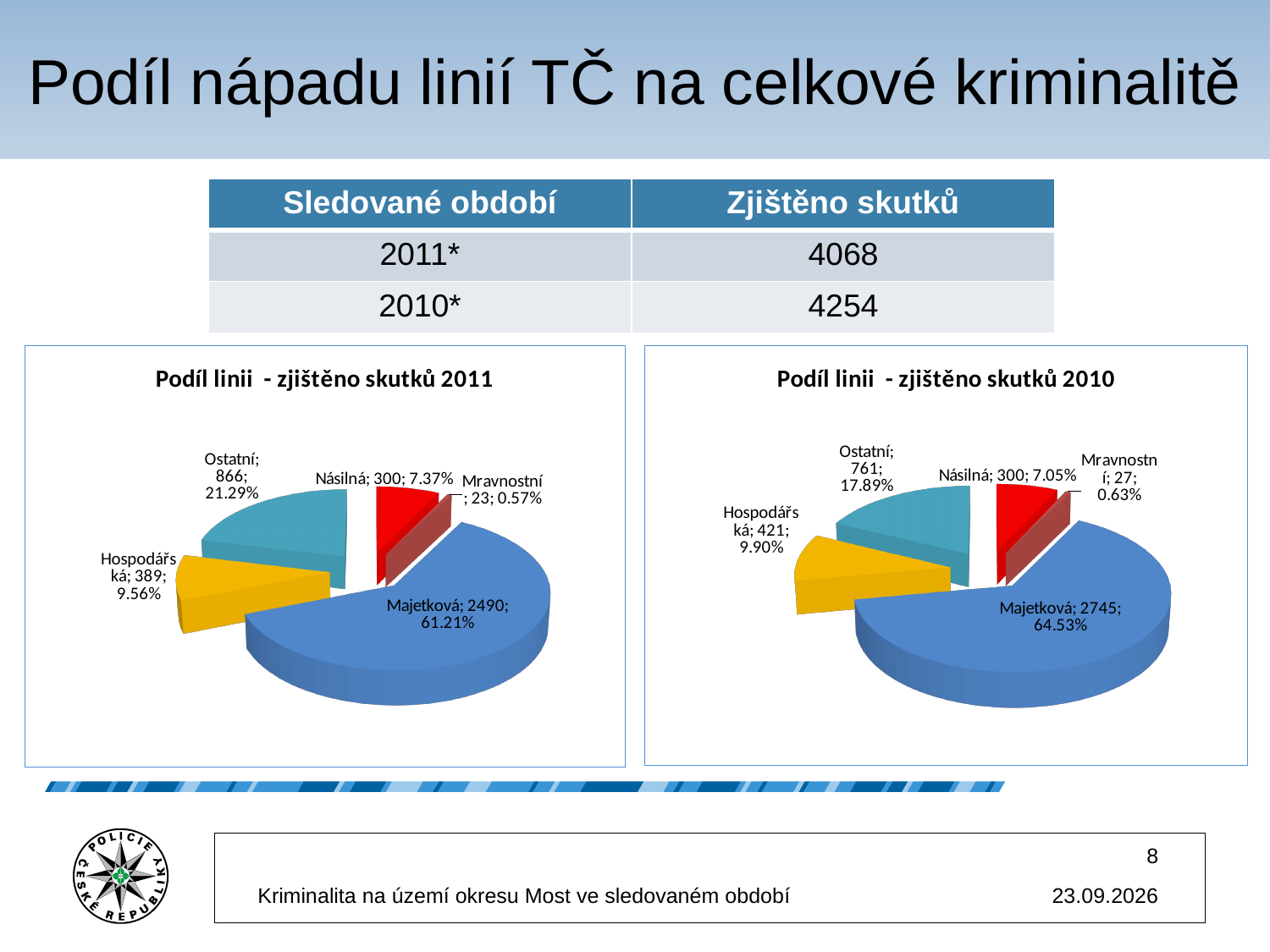
In the chart 'Podíl linii - zjištěno skutků 2011', what is the difference between the values for Ostatní and Hospodářská? 477 In the chart 'Podíl linii - zjištěno skutků 2011', what share of the pie does Ostatní have? 21.29% In the chart 'Podíl linii - zjištěno skutků 2010', which is larger, Násilná or Hospodářská? Hospodářská What kind of chart is 'Podíl linii - zjištěno skutků 2010'? Pie chart In the chart 'Podíl linii - zjištěno skutků 2011', which category has the smallest value? Mravnostní How many categories does the chart 'Podíl linii - zjištěno skutků 2011' show? 5 In the chart 'Podíl linii - zjištěno skutků 2011', what is the value for Majetková? 2490 In the chart 'Podíl linii - zjištěno skutků 2010', which category has the largest value? Majetková In the chart 'Podíl linii - zjištěno skutků 2010', what is the difference between the values for Majetková and Ostatní? 1984 In the chart 'Podíl linii - zjištěno skutků 2011', what colour is the Majetková slice? Blue In the chart 'Podíl linii - zjištěno skutků 2010', what share of the pie does Majetková have? 64.53% In the chart 'Podíl linii - zjištěno skutků 2010', what is the value for Hospodářská? 421